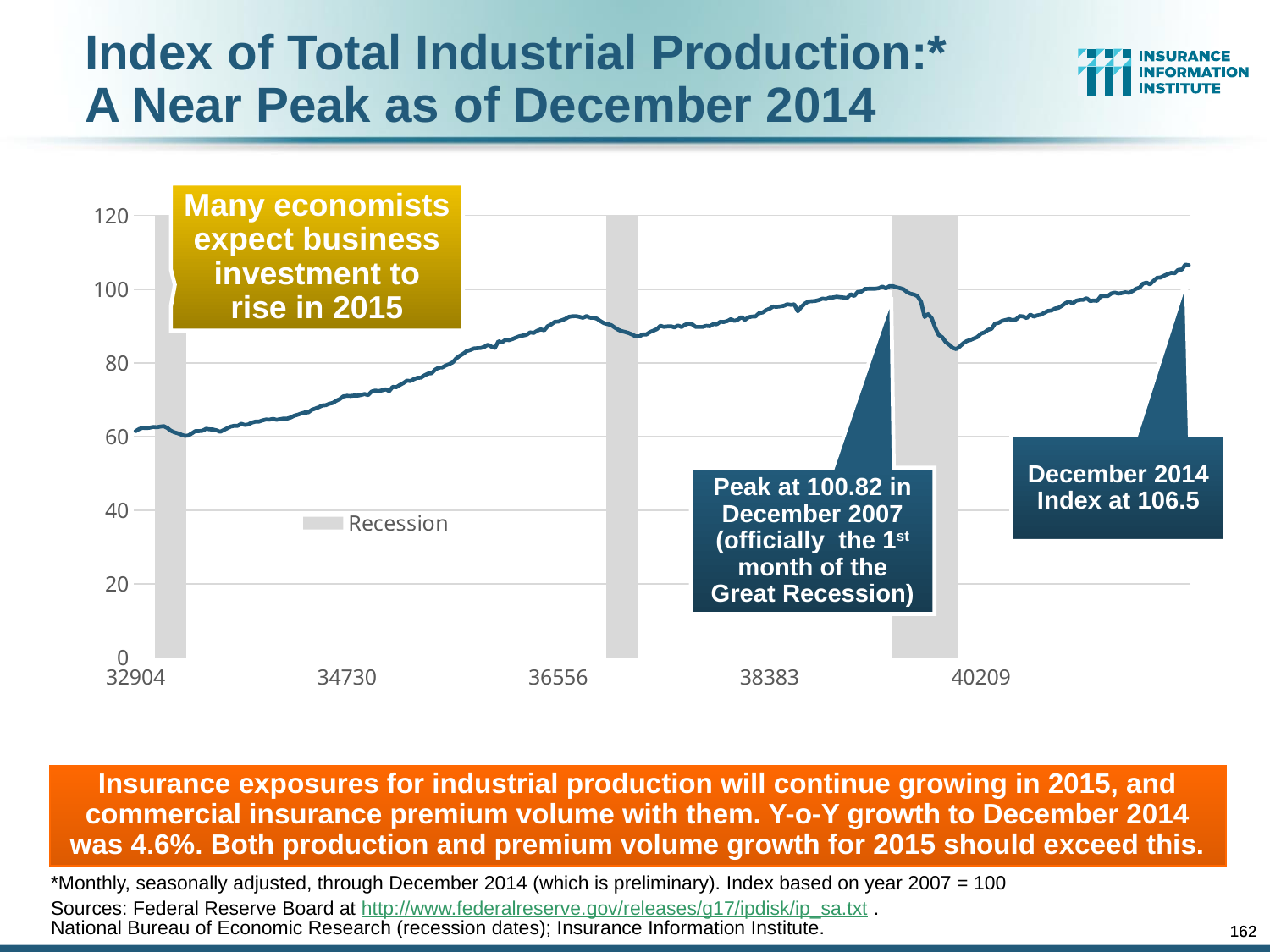
Is the index value at the start of the series (leftmost point) greater or less than 80? less By how much does the December 2014 index value exceed the December 2007 peak? 5.68 What is the highest value labeled on the y-axis? 120 How many gray shaded recession bands are shown on the chart? 3 What was the peak value of the index in December 2007? 100.82 What does the gray shading on the chart represent, according to the legend? Recession Does the index generally rise or fall from the left to the right of the chart? rise Which is higher: the index in December 2007 or in December 2014? December 2014 What is the value of the Index of Total Industrial Production in December 2014? 106.5 What kind of chart is shown on the slide? line chart Is the index value at the x-axis tick 40209 greater or less than 100? less